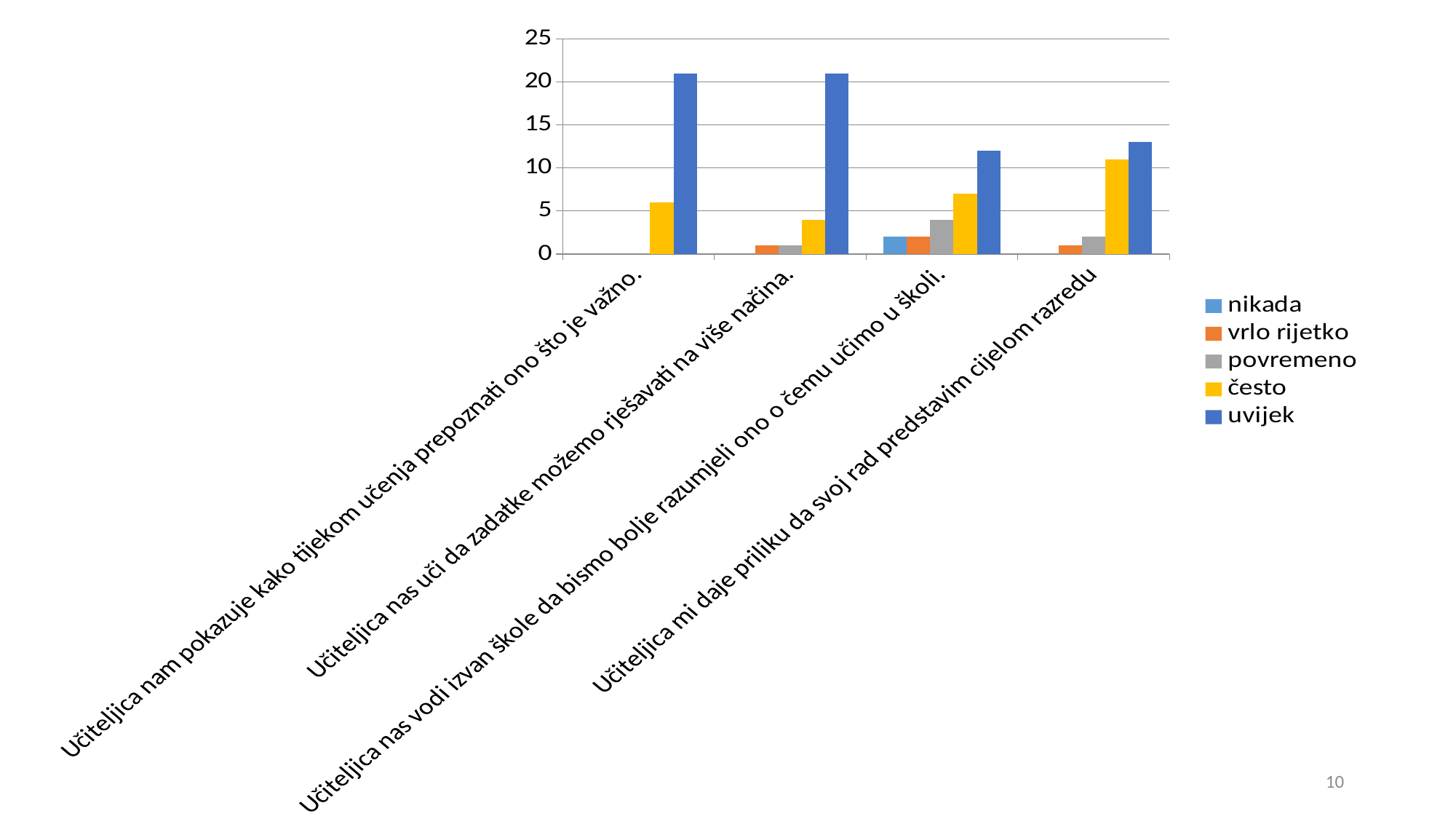
Is the "uvijek" value for "Učiteljica nas vodi izvan škole da bismo bolje razumjeli ono o čemu učimo u školi." greater or less than 15? less How many categories (statements) are shown on the x axis? 4 Is the "često" value for "Učiteljica nam pokazuje kako tijekom učenja prepoznati ono što je važno." greater or less than 10? less Which series has the highest bar for the statement "Učiteljica nam pokazuje kako tijekom učenja prepoznati ono što je važno."? uvijek Is the "često" value for "Učiteljica mi daje priliku da svoj rad predstavim cijelom razredu" greater or less than 10? greater Which series is listed first in the legend? nikada How many series does the legend list? 5 Which series is shown in yellow in the legend? često What kind of chart is shown on the slide? bar chart Which statement has the highest "često" bar? Učiteljica mi daje priliku da svoj rad predstavim cijelom razredu For "Učiteljica mi daje priliku da svoj rad predstavim cijelom razredu", which is larger: the "često" bar or the "povremeno" bar? često